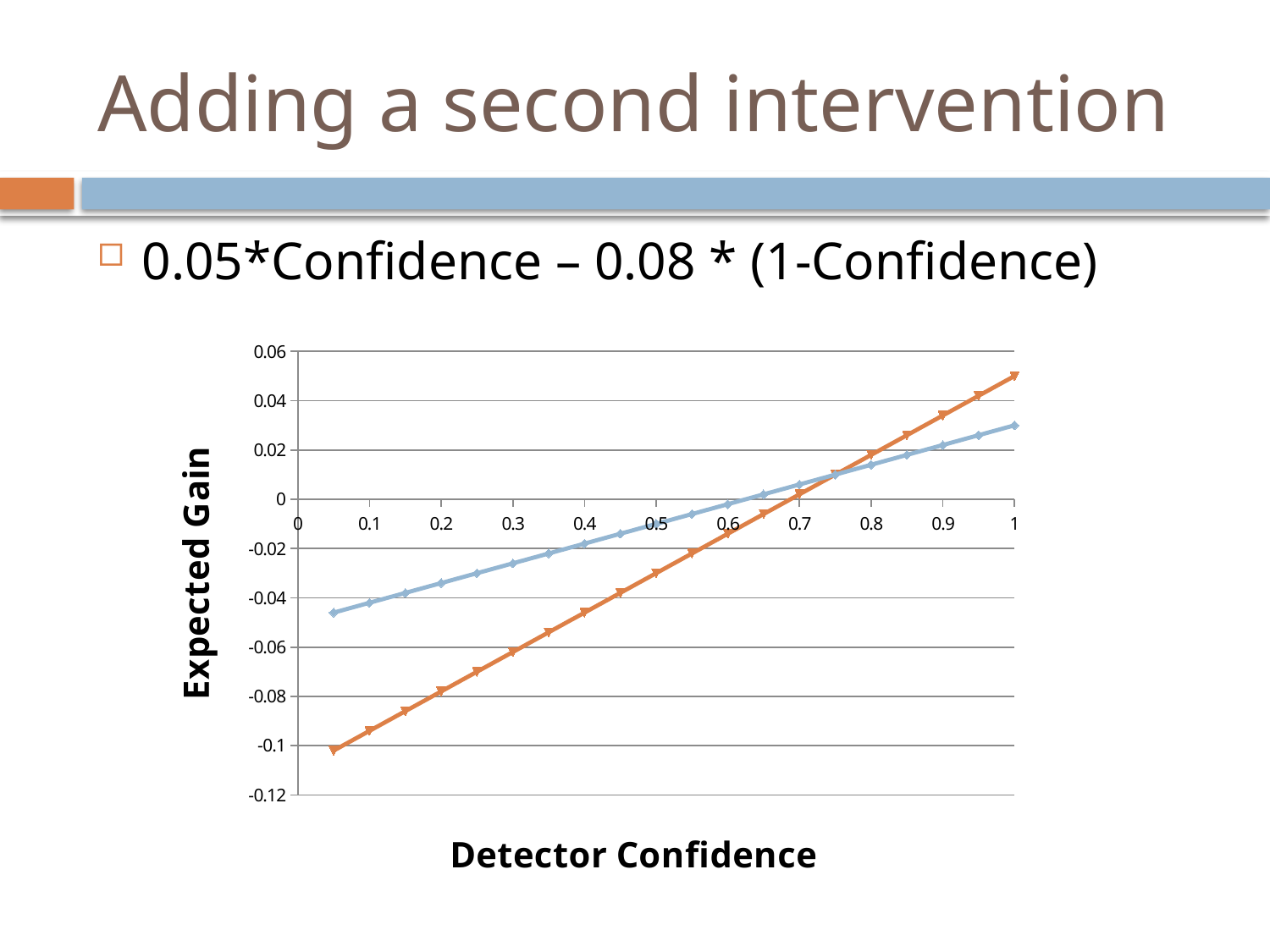
At Detector Confidence 0.1, which line has the higher Expected Gain, the blue line or the orange line? blue line Do the values of the blue line rise or fall as Detector Confidence increases? rise At Detector Confidence 1, which line has the higher Expected Gain, the blue line or the orange line? orange line Is the value of the orange line at Detector Confidence 0.1 greater or less than -0.08? less What is the title of the x axis? Detector Confidence Is the value of the orange line at Detector Confidence 1 greater or less than 0.04? greater What is the title of the y axis? Expected Gain How many lines are plotted on the chart? 2 What kind of chart is shown on the slide? line chart Do the values of the orange line rise or fall as Detector Confidence increases? rise Is the value of the blue line at Detector Confidence 1 greater or less than 0.02? greater